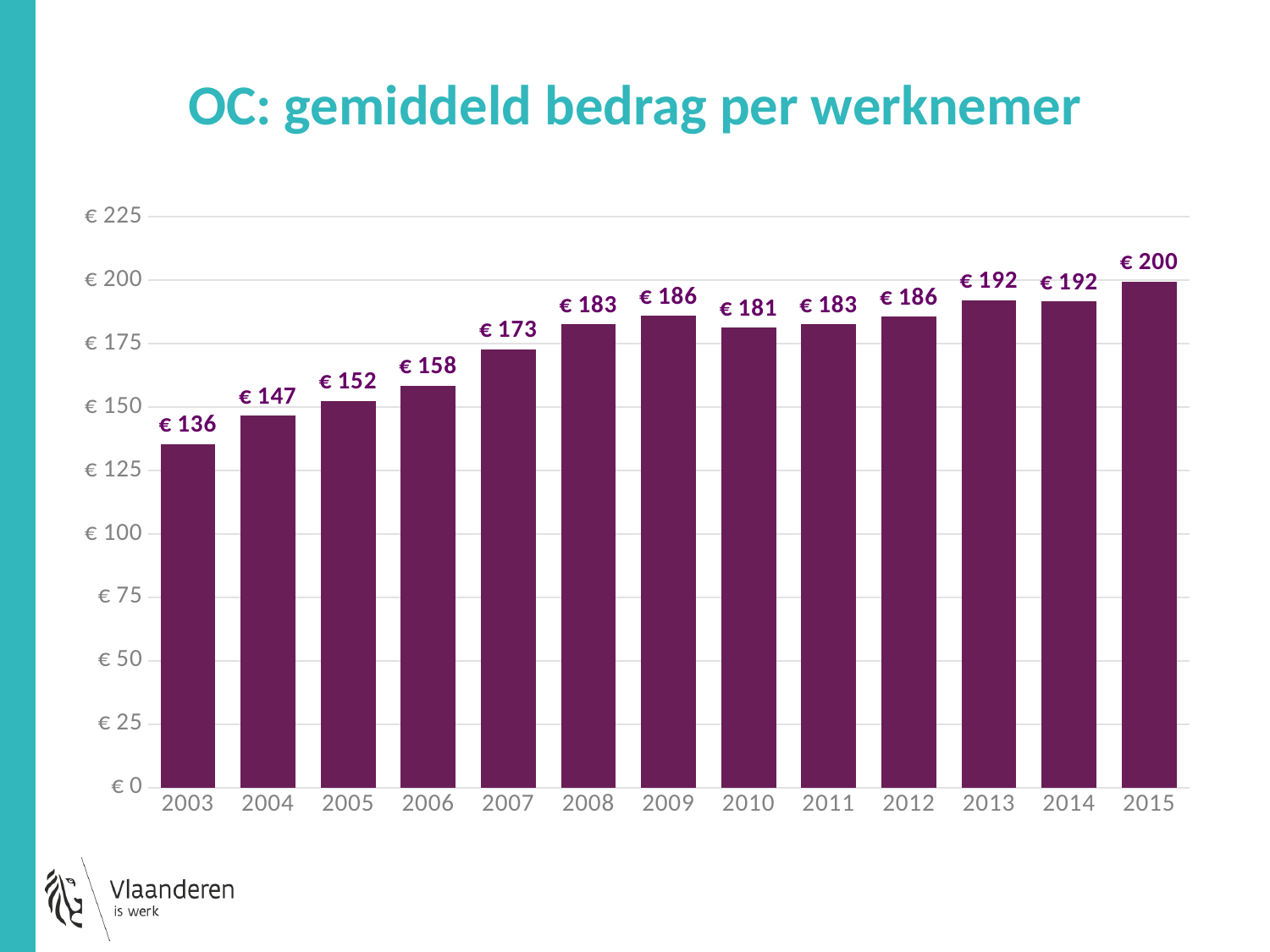
What is the value for 2010? € 181 What is the title of the chart? OC: gemiddeld bedrag per werknemer Which year has the lowest value? 2003 Do the values generally rise or fall from 2003 to 2015? Rise How many years are shown on the x axis? 13 What kind of chart is this? Bar chart What is the value for 2015? € 200 Which is larger, the value for 2007 or the value for 2008? 2008 What is the value for 2003? € 136 What is the difference between the values for 2009 and 2010? € 5 Which year has the highest value? 2015 What is the difference between the values for 2015 and 2003? € 64